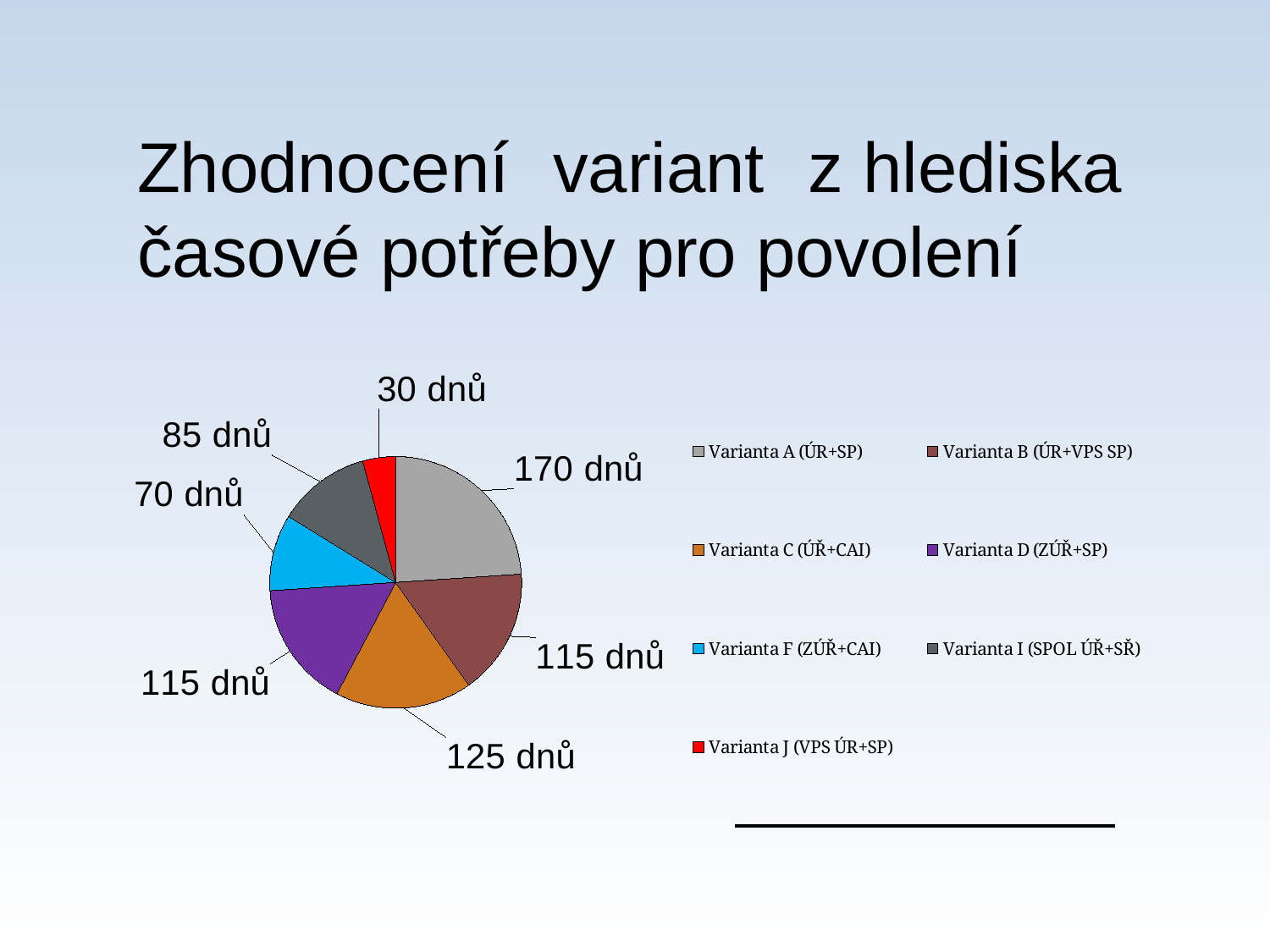
What is the difference between the values for Varianta A (ÚR+SP) and Varianta J (VPS ÚR+SP)? 140 dnů What is the value for Varianta F (ZÚŘ+CAI)? 70 dnů Which variant has the smallest slice of the pie? Varianta J (VPS ÚR+SP) What colour is the slice for Varianta J (VPS ÚR+SP)? red What is the value for Varianta I (SPOL ÚŘ+SŘ)? 85 dnů Which is larger, the value for Varianta C (ÚŘ+CAI) or Varianta I (SPOL ÚŘ+SŘ)? Varianta C (ÚŘ+CAI) What kind of chart is shown on the slide? pie chart What is the value for Varianta C (ÚŘ+CAI)? 125 dnů Which variant has the largest slice of the pie? Varianta A (ÚR+SP) How many slices does the pie chart have? 7 What is the value for Varianta J (VPS ÚR+SP)? 30 dnů What is the value for Varianta A (ÚR+SP)? 170 dnů